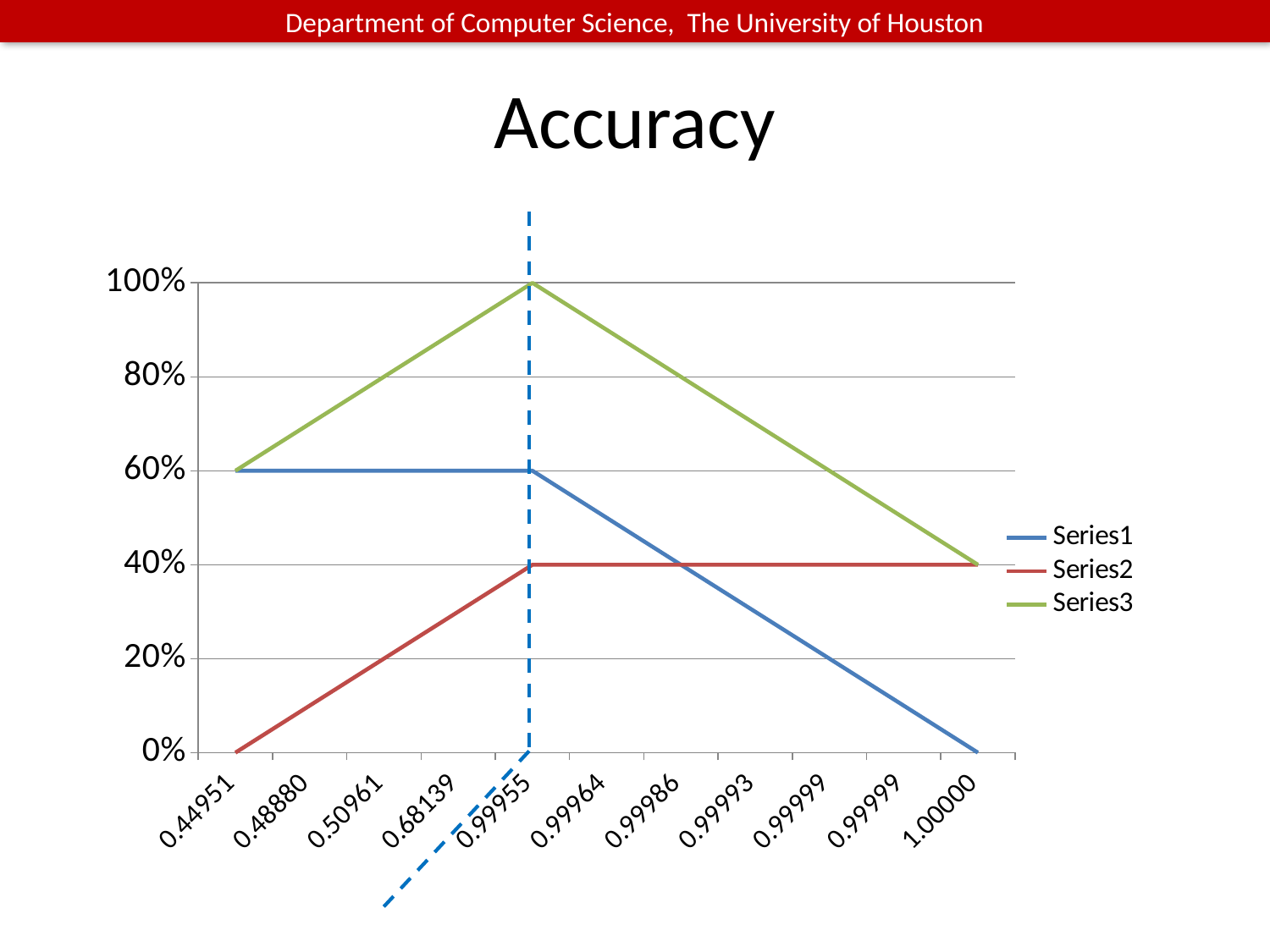
Is the value of Series3 at 0.99986 greater or less than 60%? greater What is the value of Series3 at 0.99955? 100% At 0.99955, which is larger: Series3 or Series1? Series3 At which x-axis category does Series3 reach its highest value? 0.99955 How many categories are shown on the x axis? 11 What is the title of the chart? Accuracy Does Series1 rise or fall between 0.99955 and 1.00000? fall How many series does the legend list? 3 What is the value of Series2 at 0.44951? 0% What is the value of Series1 at 1.00000? 0% What is the difference between Series3 and Series2 at 0.99955? 60% What kind of chart is shown on the slide? line chart